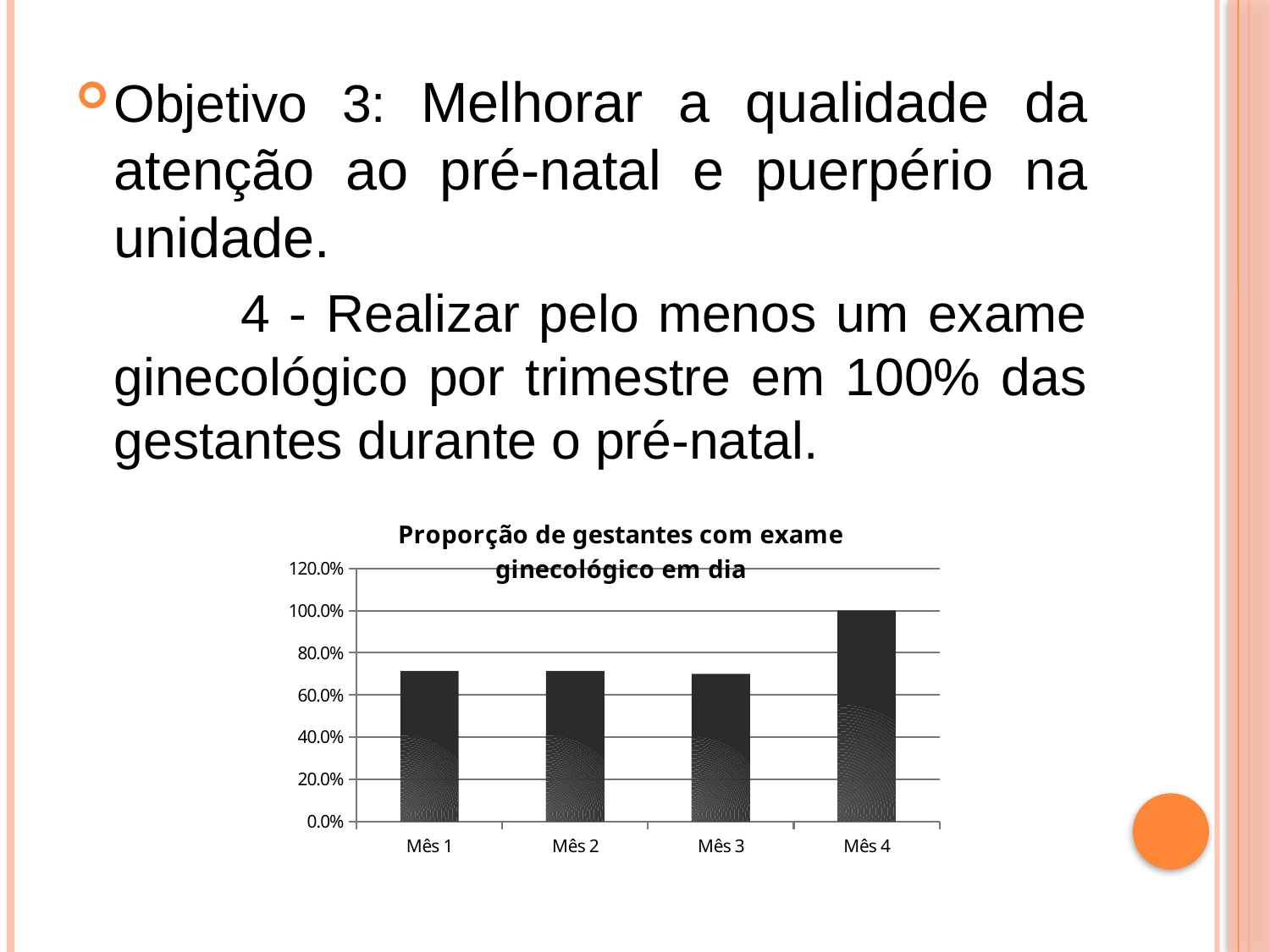
Is the value for Mês 4 greater or less than 80.0%? greater Which is larger, the value for Mês 3 or the value for Mês 4? Mês 4 Is the value for Mês 1 greater or less than 60.0%? greater What is the highest value shown on the y axis of the chart? 120.0% Is the value for Mês 2 greater or less than 80.0%? less Does the value rise or fall from Mês 3 to Mês 4? rise Which month has the highest proportion of pregnant women with an up-to-date gynecological exam? Mês 4 What is the title of the chart? Proporção de gestantes com exame ginecológico em dia What is the value for Mês 4? 100.0% What kind of chart is shown on the slide? bar chart How many months (categories) are shown on the x axis of the chart? 4